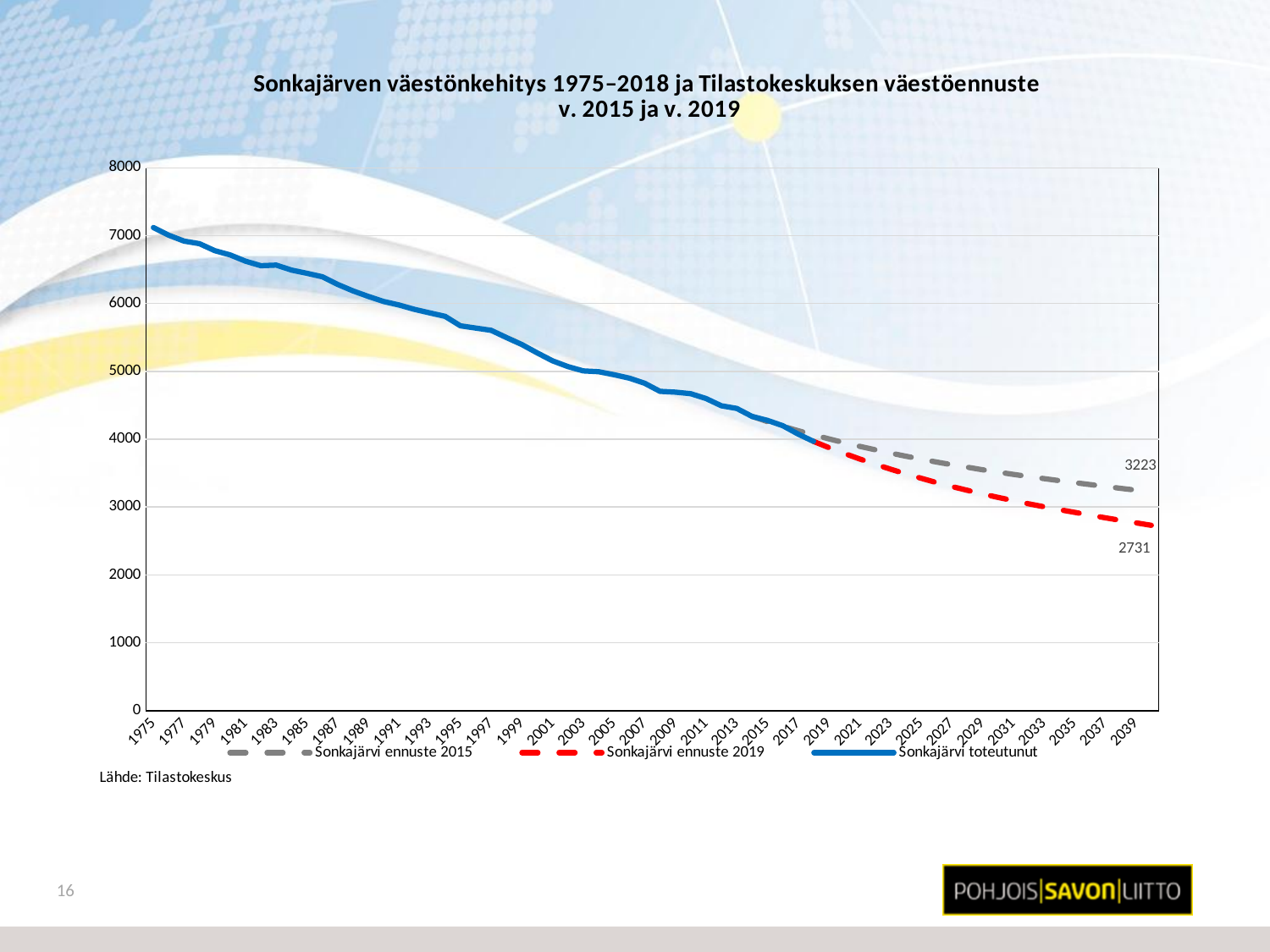
What is the difference between the final labelled values of the 2015 forecast (3223) and the 2019 forecast (2731)? 492 What is the title of the chart? Sonkajärven väestönkehitys 1975–2018 ja Tilastokeskuksen väestöennuste v. 2015 ja v. 2019 Is the value of Sonkajärvi toteutunut in 1975 greater or less than 6000? greater Does the Sonkajärvi toteutunut series rise or fall from 1975 to 2018? fall How many series does the legend list? 3 Which forecast series ends at a higher value, Sonkajärvi ennuste 2015 or Sonkajärvi ennuste 2019? Sonkajärvi ennuste 2015 What is the final labelled value of the Sonkajärvi ennuste 2019 series? 2731 What kind of chart is shown on the slide? line chart Is the value of Sonkajärvi toteutunut in 2017 greater or less than 5000? less What is the final labelled value of the Sonkajärvi ennuste 2015 series? 3223 What colour is the Sonkajärvi toteutunut line? blue Is the value of Sonkajärvi toteutunut in 2005 greater or less than 4000? greater